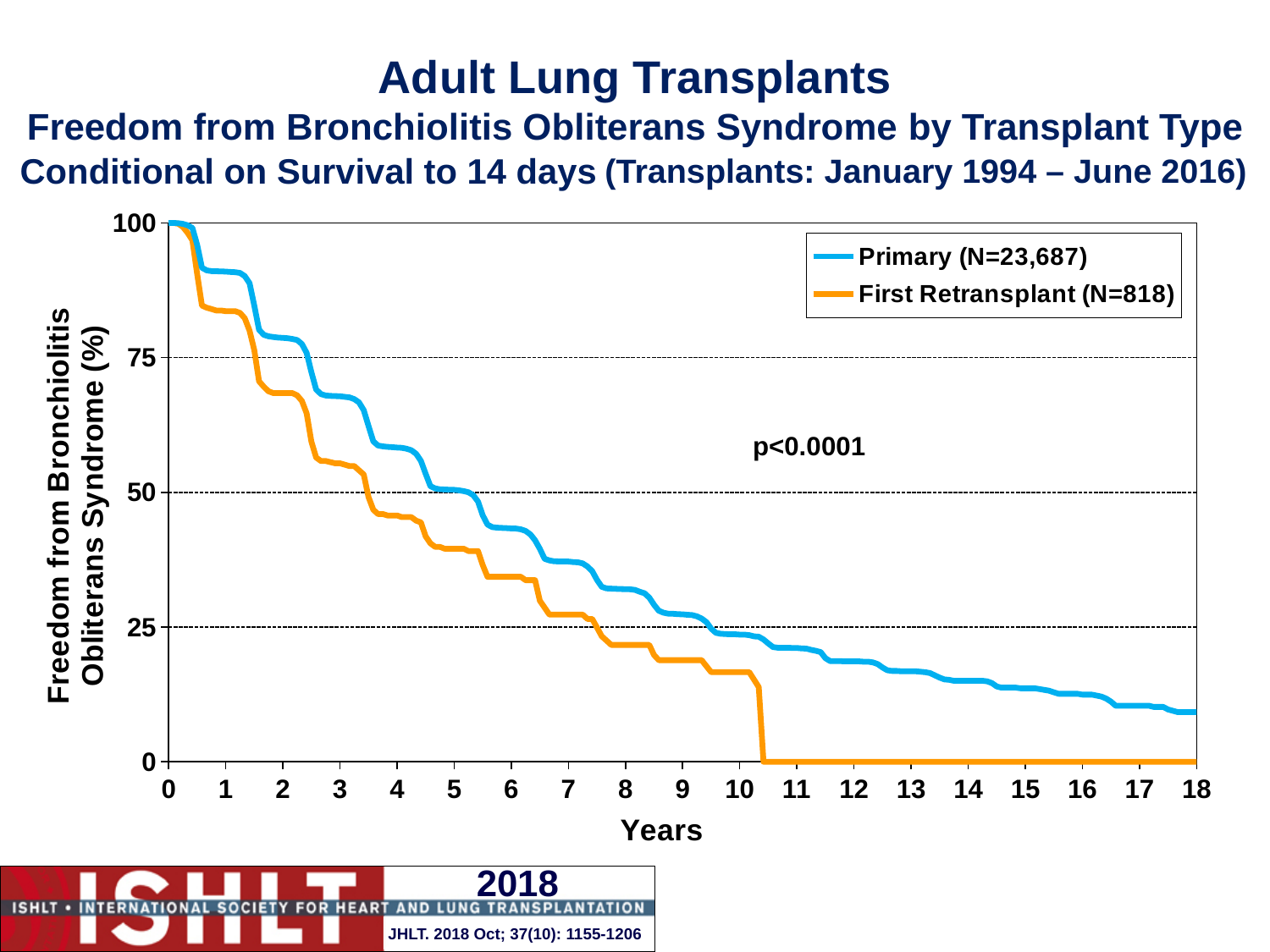
Do the values for the Primary series rise or fall as years increase? fall Is the value for Primary at year 1 greater or less than 75? greater What value does the First Retransplant curve drop to after about year 10.5? 0 What kind of chart is shown on the slide? line chart Is the value for Primary at year 3 greater or less than 50? greater At year 8, which series has the higher value, Primary or First Retransplant? Primary What p-value is printed on the chart? p<0.0001 Is the value for First Retransplant at year 5 greater or less than 50? less At year 5, which series has the lower value, Primary or First Retransplant? First Retransplant How many series does the legend list? 2